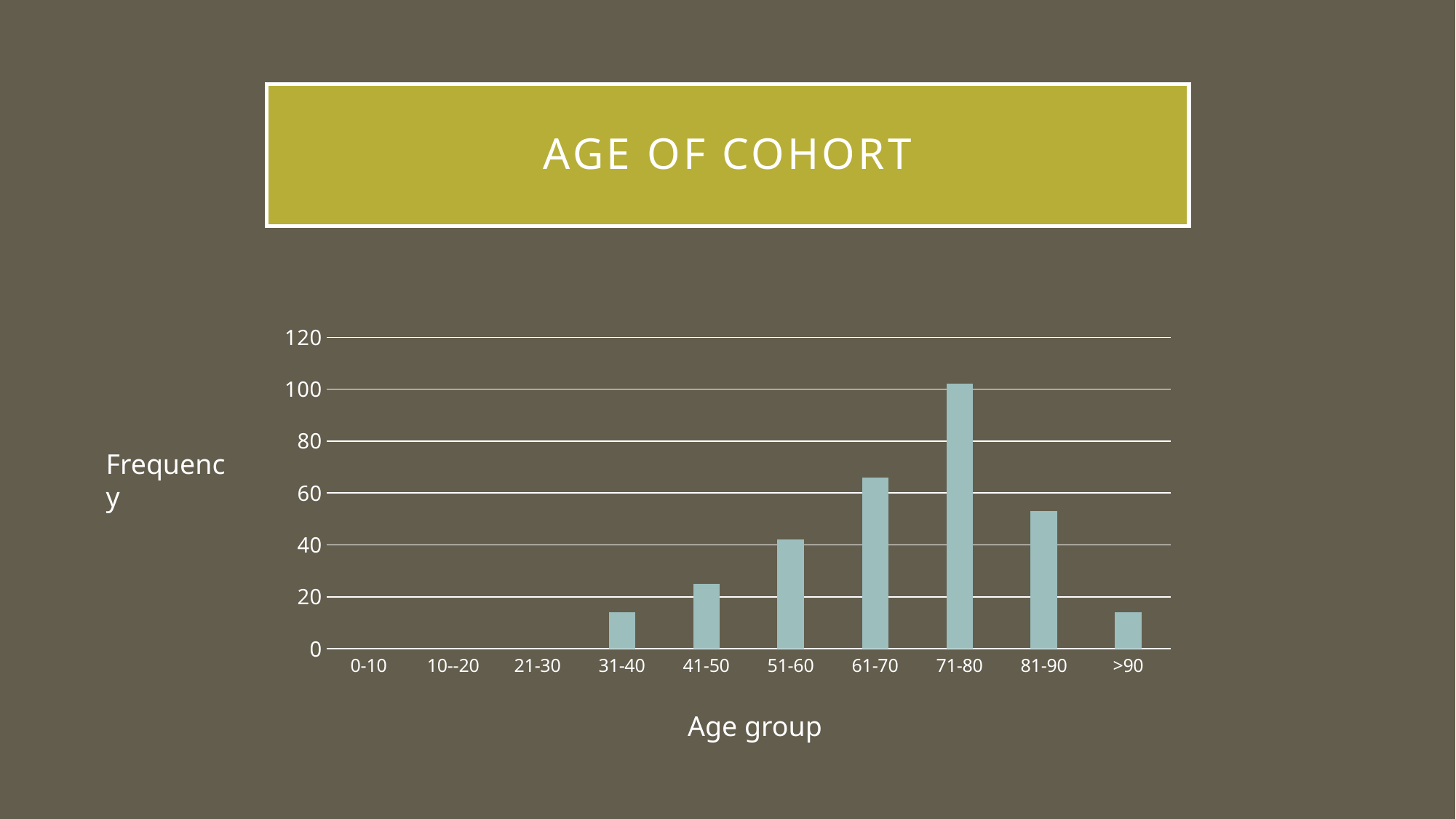
What kind of chart is shown on the slide? bar chart Which has a higher frequency, the 51-60 age group or the 41-50 age group? 51-60 Is the frequency for the 61-70 age group greater or less than 60? greater Is the frequency for the 31-40 age group greater or less than 20? less Is the frequency for the 81-90 age group greater or less than 60? less What is the title of the slide? AGE OF COHORT What is the label of the y axis? Frequency How many age group categories are shown on the x axis? 10 Which age group has the highest frequency? 71-80 Which has a higher frequency, the 61-70 age group or the 81-90 age group? 61-70